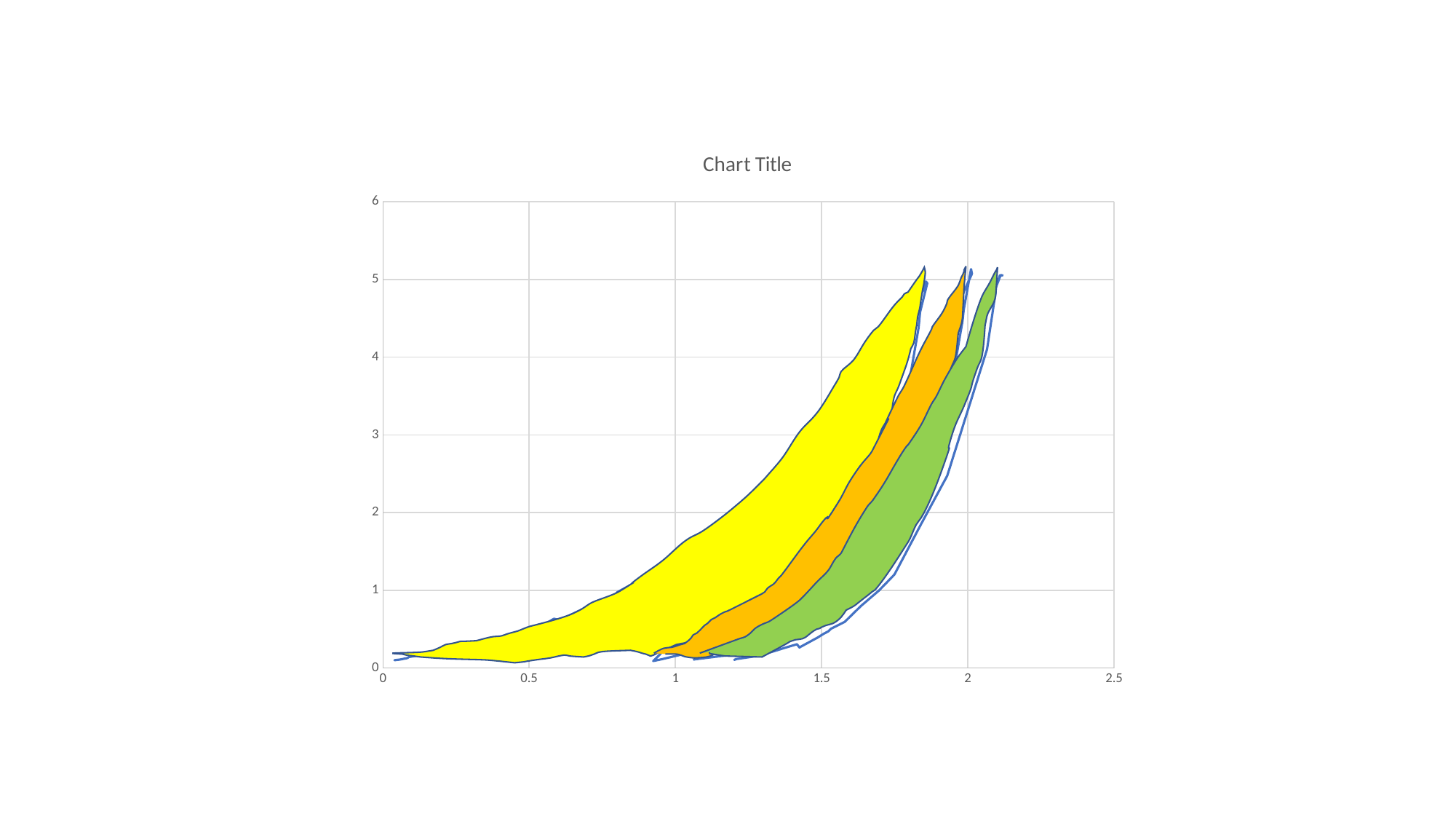
Which shaded region extends furthest to the right on the x axis? Green Is the highest y value reached by the yellow region greater or less than 4? greater Is the y value of the orange region at x = 1.5 greater or less than 3? less Is the x value at which the yellow region begins greater or less than 0.5? less Do the plotted values rise or fall as x increases along the x axis? Rise How many shaded regions are plotted in the chart? 3 Which shaded region extends furthest to the left on the x axis? Yellow What is the title of the chart? Chart Title What three fill colours are used for the shaded regions in the chart? Yellow, orange and green